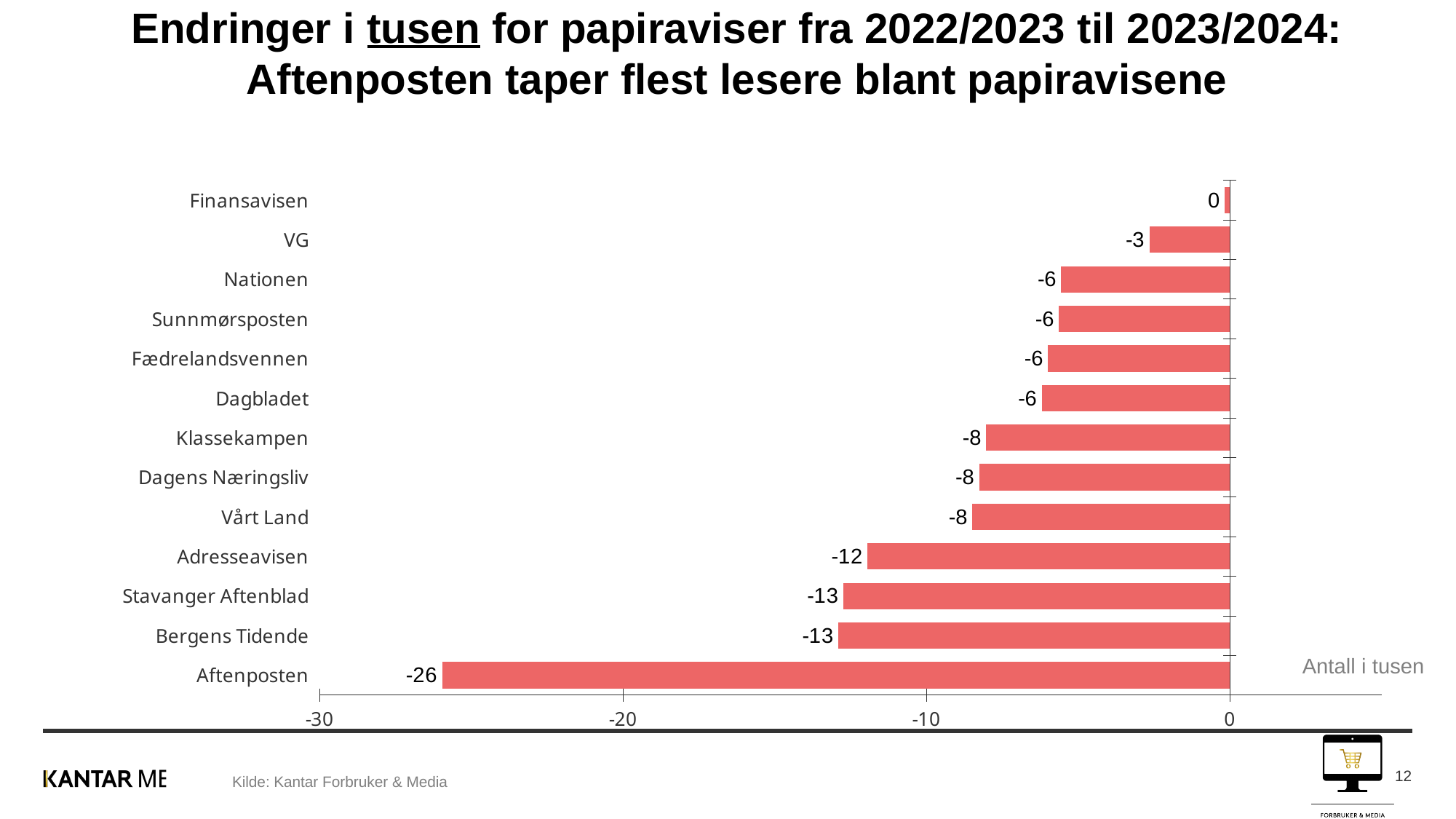
What is the value shown for Adresseavisen? -12 Which newspaper has the lowest (most negative) value? Aftenposten What is the difference between the values for Aftenposten and Bergens Tidende? 13 Is the value for Stavanger Aftenblad greater or less than -10? less What is the value shown for VG? -3 Which has a larger (less negative) value, VG or Dagbladet? VG What is the value shown for Finansavisen? 0 What is the label shown next to the x axis of the chart? Antall i tusen What is the value shown for Aftenposten? -26 What kind of chart is shown on the slide? Bar chart How many newspapers are shown in the chart? 13 Which newspaper has the highest value? Finansavisen